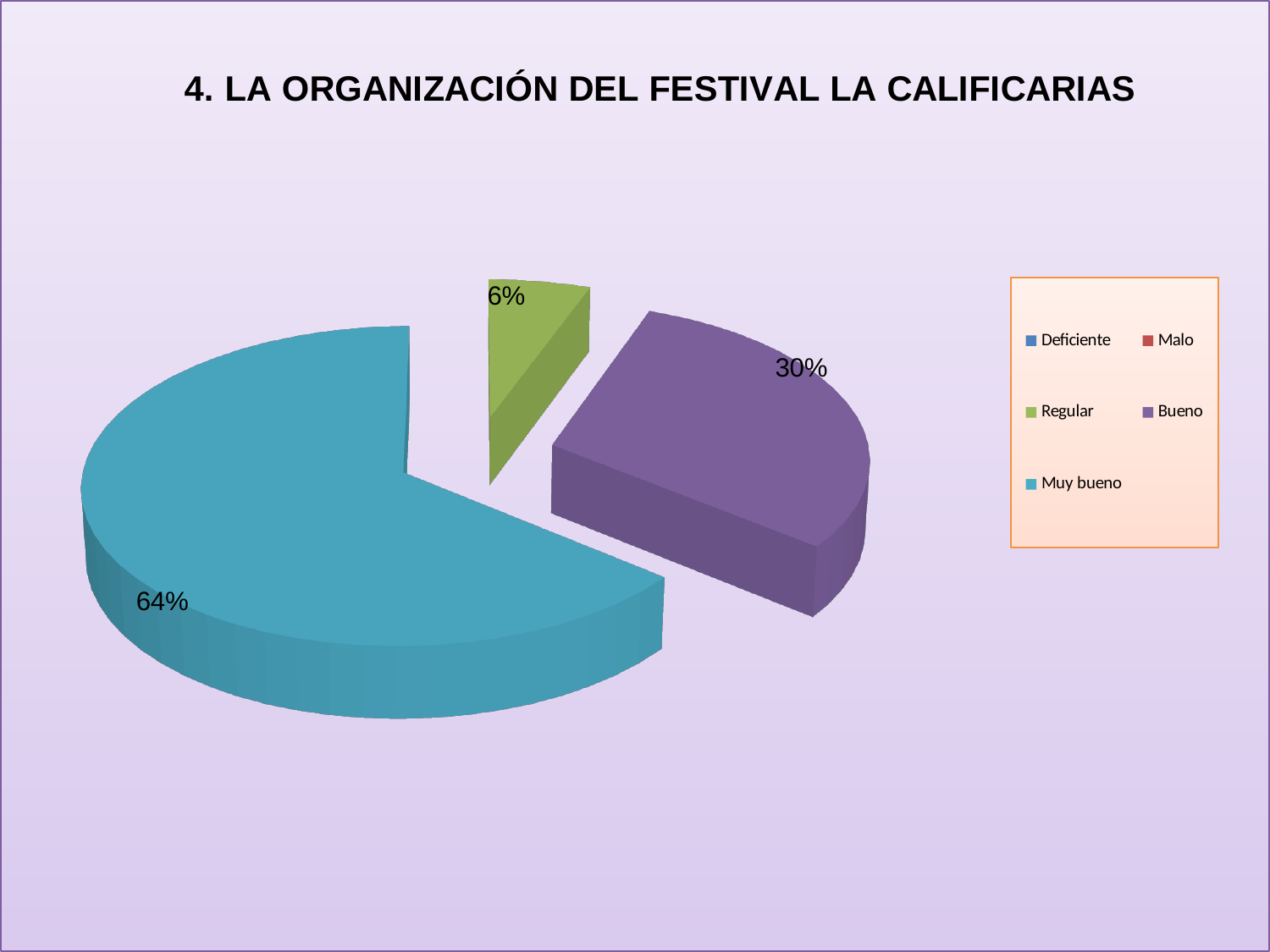
Which of the visible slices is the smallest? Regular Which is larger, the Bueno slice or the Regular slice? Bueno What is the title of the chart? 4. LA ORGANIZACIÓN DEL FESTIVAL LA CALIFICARIAS How many categories does the legend list? 5 What percentage of the pie is labelled for Muy bueno? 64% What kind of chart is shown on the slide? pie chart What percentage of the pie is labelled for Regular? 6% What is the combined percentage of Bueno and Regular? 36% What is the difference in percentage points between Muy bueno and Bueno? 34 Which category has the largest slice of the pie? Muy bueno What colour is the Muy bueno slice? teal What percentage of the pie is labelled for Bueno? 30%